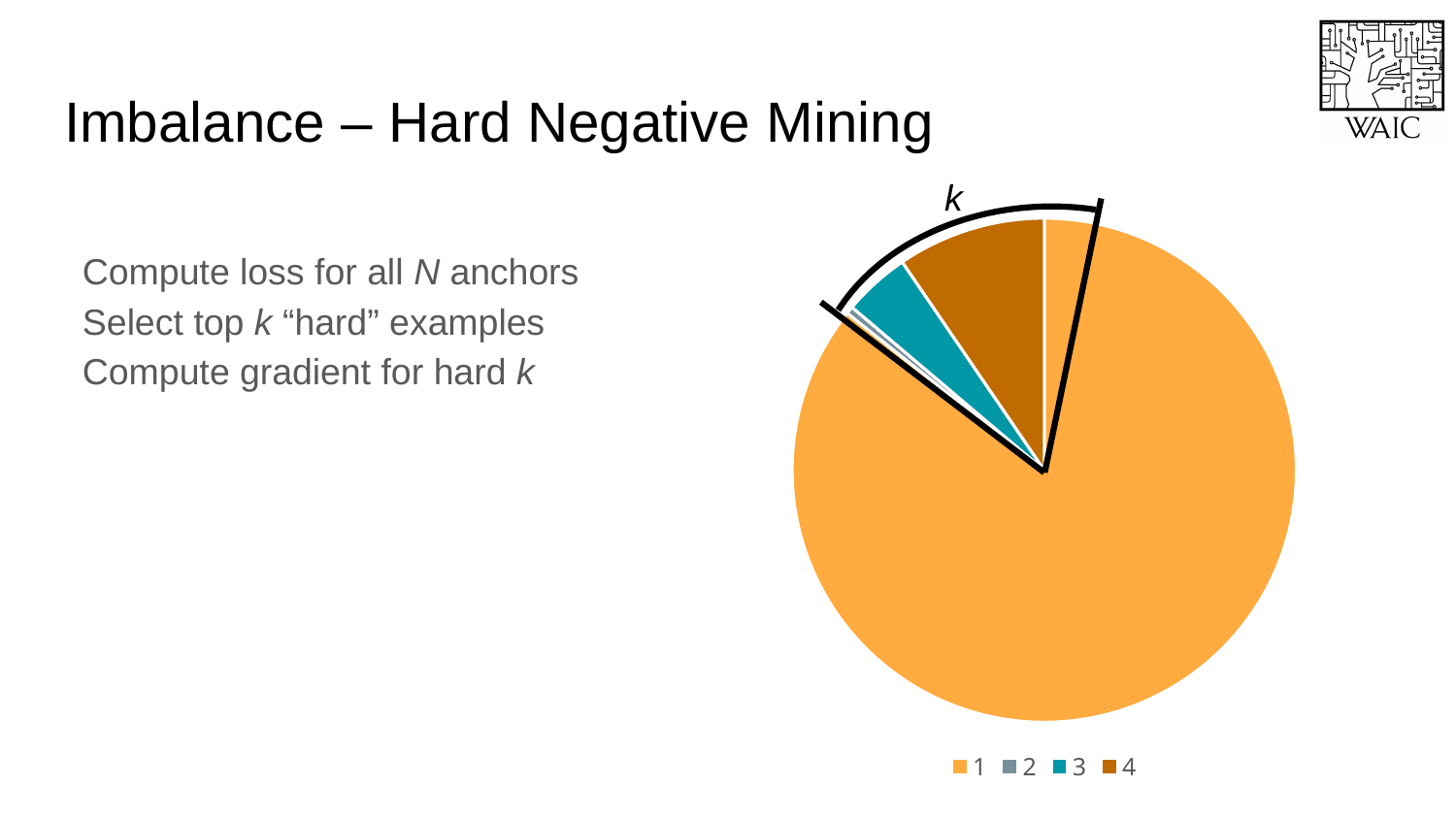
Does the slice for category 1 take up more or less than half of the pie? more What are the legend entries of the pie chart, in order? 1, 2, 3, 4 How many entries does the legend of the pie chart list? 4 Which slice is larger in the pie chart, category 1 or category 3? 1 Which slice is larger in the pie chart, category 4 or category 3? 4 What kind of chart is shown on the slide? pie chart Which category has the largest slice in the pie chart? 1 How many slices does the pie chart have? 4 Which category has the smallest slice in the pie chart? 2 What colour is the slice for category 1 in the pie chart? orange